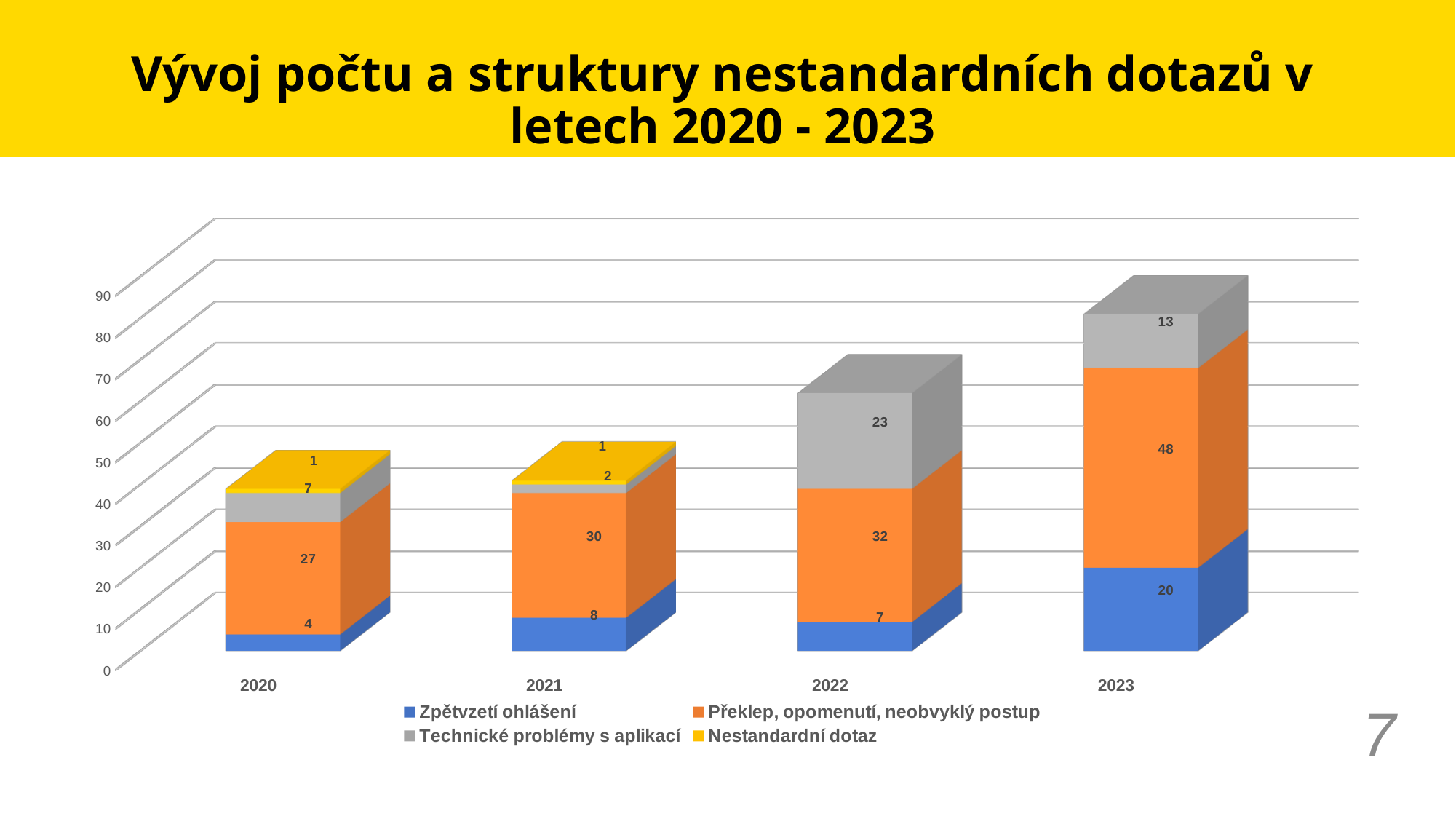
What is the value for Překlep, opomenutí, neobvyklý postup in 2023? 48 What is the value for Technické problémy s aplikací in 2022? 23 What is the value for Zpětvzetí ohlášení in 2020? 4 How many series does the legend list? 4 In which year is the value for Technické problémy s aplikací lowest? 2021 How many years (categories) are shown on the x axis? 4 What is the total of the stacked bar for 2020? 39 What is the value for Nestandardní dotaz in 2021? 1 Which is larger: Technické problémy s aplikací in 2022 or in 2023? 2022 In which year is the value for Zpětvzetí ohlášení highest? 2023 What is the difference between the Překlep, opomenutí, neobvyklý postup values for 2023 and 2022? 16 What type of chart is shown on the slide? Stacked bar chart